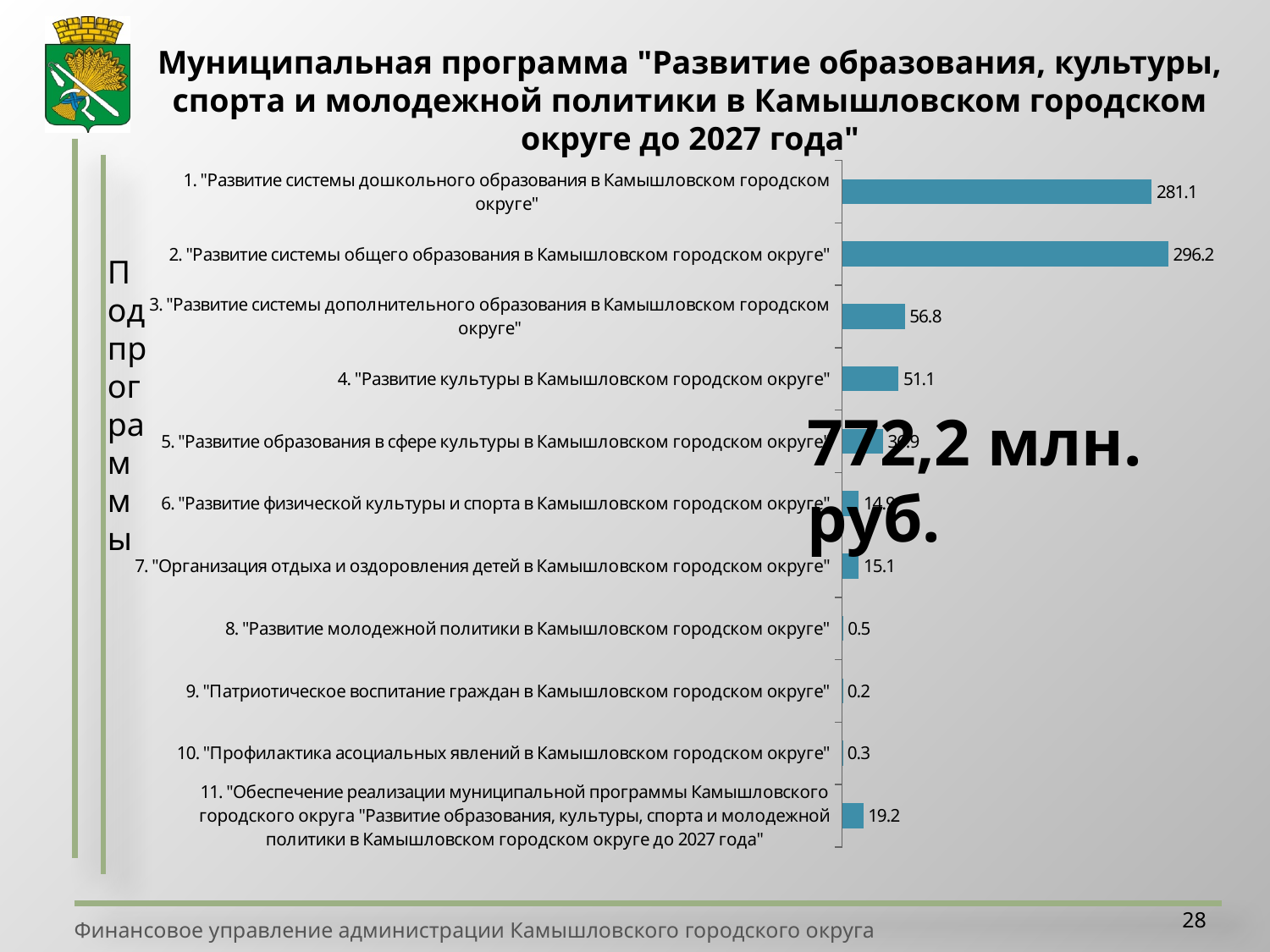
How many subprograms (categories) are plotted in the chart? 11 What type of chart is shown on the slide? bar chart What is the value for subprogram 11, "Обеспечение реализации муниципальной программы..."? 19.2 Which subprogram has the lowest value in the chart? 9. "Патриотическое воспитание граждан в Камышловском городском округе" What is the value for subprogram 1, "Развитие системы дошкольного образования в Камышловском городском округе"? 281.1 What is the value for subprogram 3, "Развитие системы дополнительного образования в Камышловском городском округе"? 56.8 What is the difference between the values for subprogram 2 (296.2) and subprogram 1 (281.1)? 15.1 Which subprogram has the highest value in the chart? 2. "Развитие системы общего образования в Камышловском городском округе" What total amount in million rubles is printed in large text over the chart? 772,2 млн. руб. What is the value for subprogram 4, "Развитие культуры в Камышловском городском округе"? 51.1 Which has a larger value: subprogram 3 "Развитие системы дополнительного образования" or subprogram 4 "Развитие культуры"? 3. "Развитие системы дополнительного образования в Камышловском городском округе" What is the value for subprogram 2, "Развитие системы общего образования в Камышловском городском округе"? 296.2